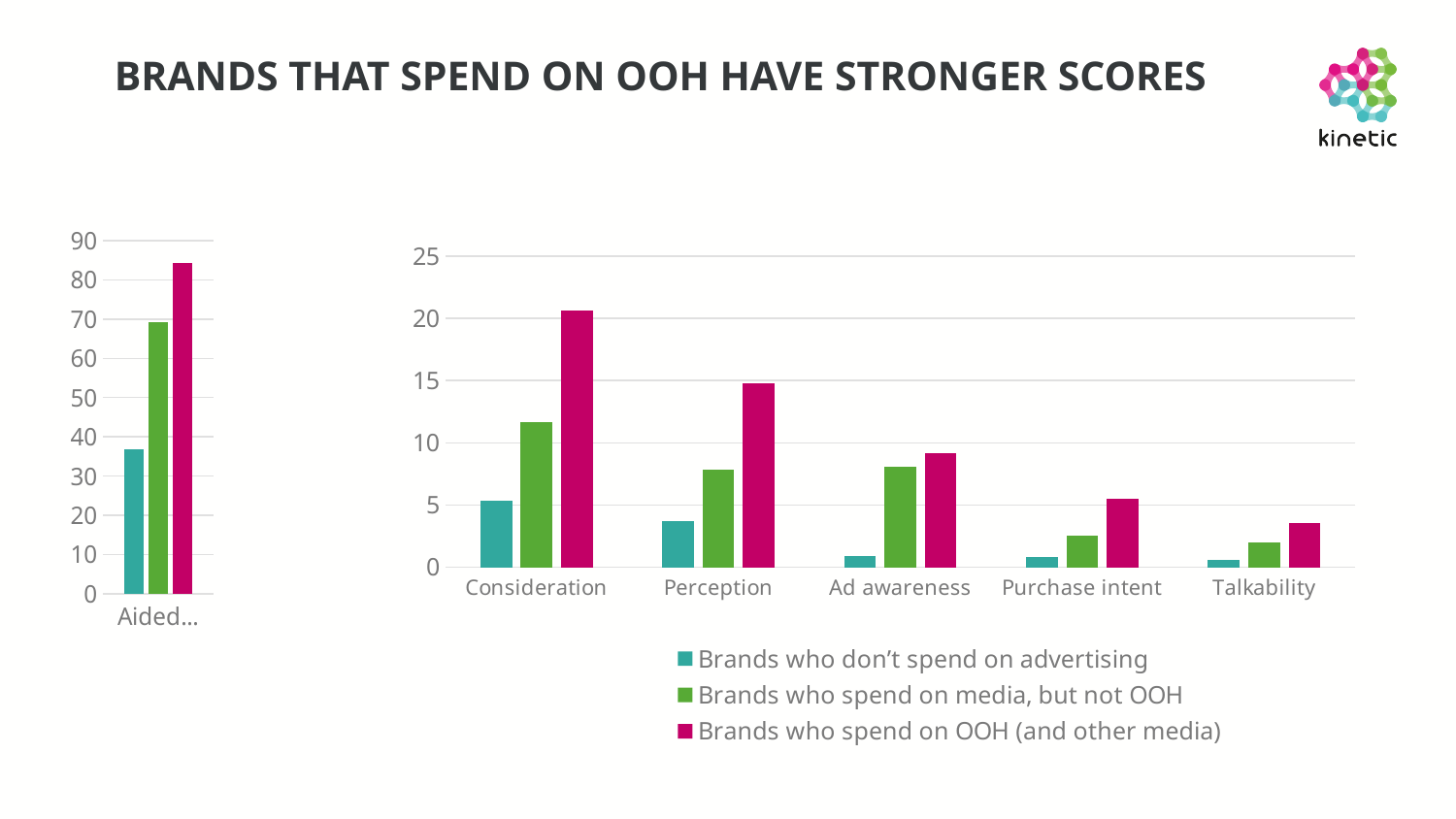
What is the title of the slide? BRANDS THAT SPEND ON OOH HAVE STRONGER SCORES How many categories are shown on the x axis of the right-hand chart? 5 What kind of chart is the chart on the right of the slide? bar chart In the right-hand chart, for which category is the value for 'Brands who spend on OOH (and other media)' lowest? Talkability In the left-hand chart, is the value for 'Brands who spend on OOH (and other media)' greater or less than 80? greater In the right-hand chart, which is larger at Perception: the value for 'Brands who spend on media, but not OOH' or the value for 'Brands who spend on OOH (and other media)'? Brands who spend on OOH (and other media) How many series does the legend list? 3 In the right-hand chart, do the values for 'Brands who spend on OOH (and other media)' rise or fall from Consideration to Talkability? fall In the right-hand chart, is the value for 'Brands who spend on OOH (and other media)' at Consideration greater or less than 20? greater In the left-hand chart, is the value for 'Brands who don't spend on advertising' greater or less than 40? less In the right-hand chart, for which category is the value for 'Brands who spend on OOH (and other media)' highest? Consideration